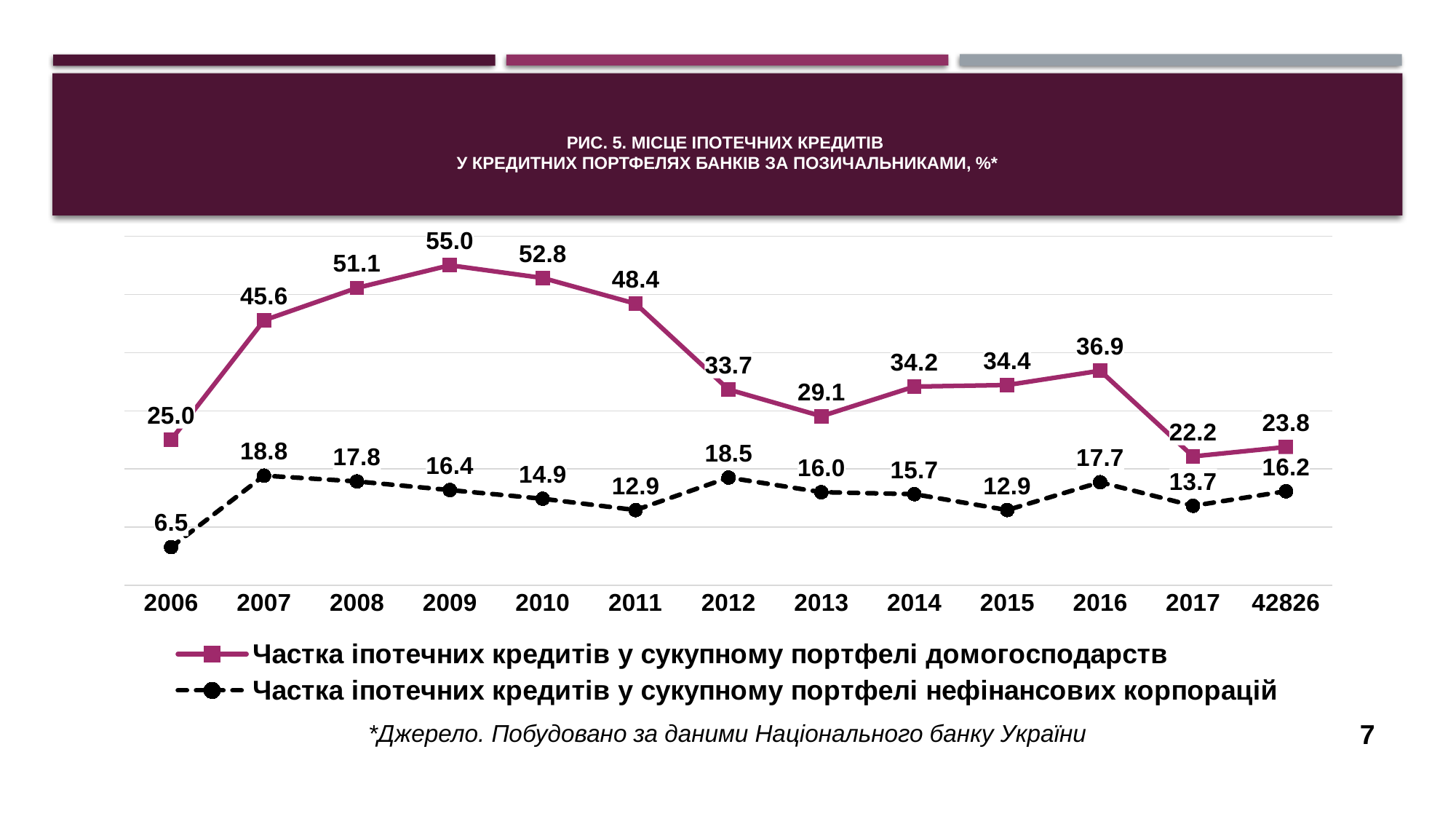
What kind of chart is shown on the slide? Line chart How many series does the legend list? 2 What is the difference between the household series and the non-financial corporations series in 2017? 8.5 Does the household series rise or fall between 2009 and 2013? Fall What is the value of the household mortgage share series (Частка іпотечних кредитів у сукупному портфелі домогосподарств) in 2009? 55.0 In which year does the household mortgage share series reach its highest value? 2009 By how much did the household series fall from 2016 to 2017? 14.7 How many categories are shown on the x axis? 13 What is the value of the non-financial corporations series (Частка іпотечних кредитів у сукупному портфелі нефінансових корпорацій) in 2012? 18.5 In which year is the non-financial corporations series at its lowest value? 2006 Which is larger for the non-financial corporations series: the value in 2007 or the value in 2011? 2007 What is the value of the household series for the last category labelled 42826? 23.8